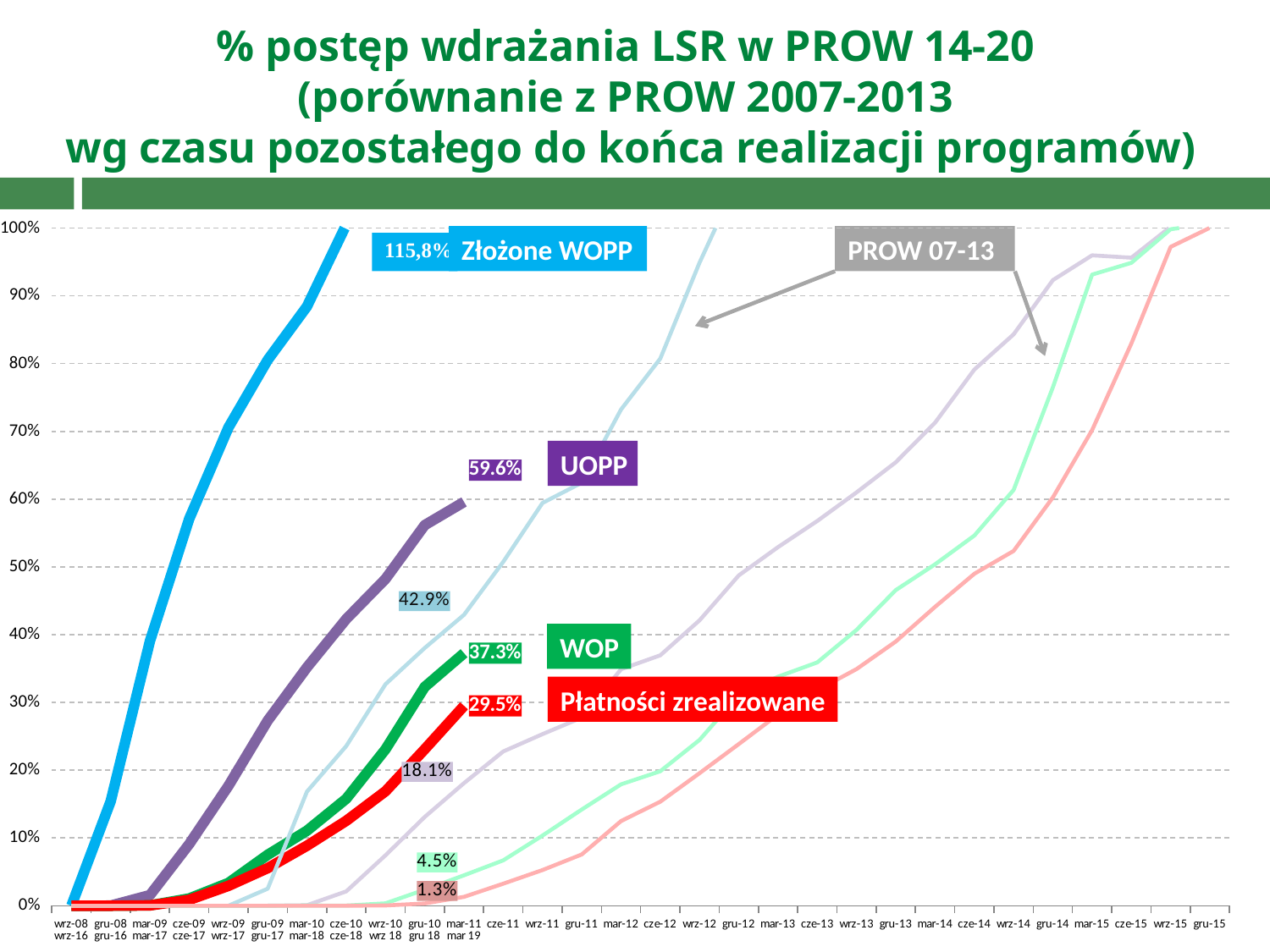
Do the plotted lines rise or fall from left to right along the x axis? rise What value is labelled for the Złożone WOPP series? 115,8% What value is labelled for the UOPP series? 59.6% What value is labelled for the Płatności zrealizowane series? 29.5% What value is labelled for the WOP series? 37.3% Which of the labelled PROW 14-20 series (Złożone WOPP, UOPP, WOP, Płatności zrealizowane) has the lowest labelled value? Płatności zrealizowane Is the value of the Złożone WOPP line at mar-10 greater or less than 50%? greater What is the difference between the labelled values for UOPP (59.6%) and WOP (37.3%)? 22.3 percentage points What colour is the Płatności zrealizowane line? red Which has the larger labelled value, WOP or Płatności zrealizowane? WOP What kind of chart is shown on the slide? line chart Which of the labelled PROW 14-20 series (Złożone WOPP, UOPP, WOP, Płatności zrealizowane) has the highest labelled value? Złożone WOPP